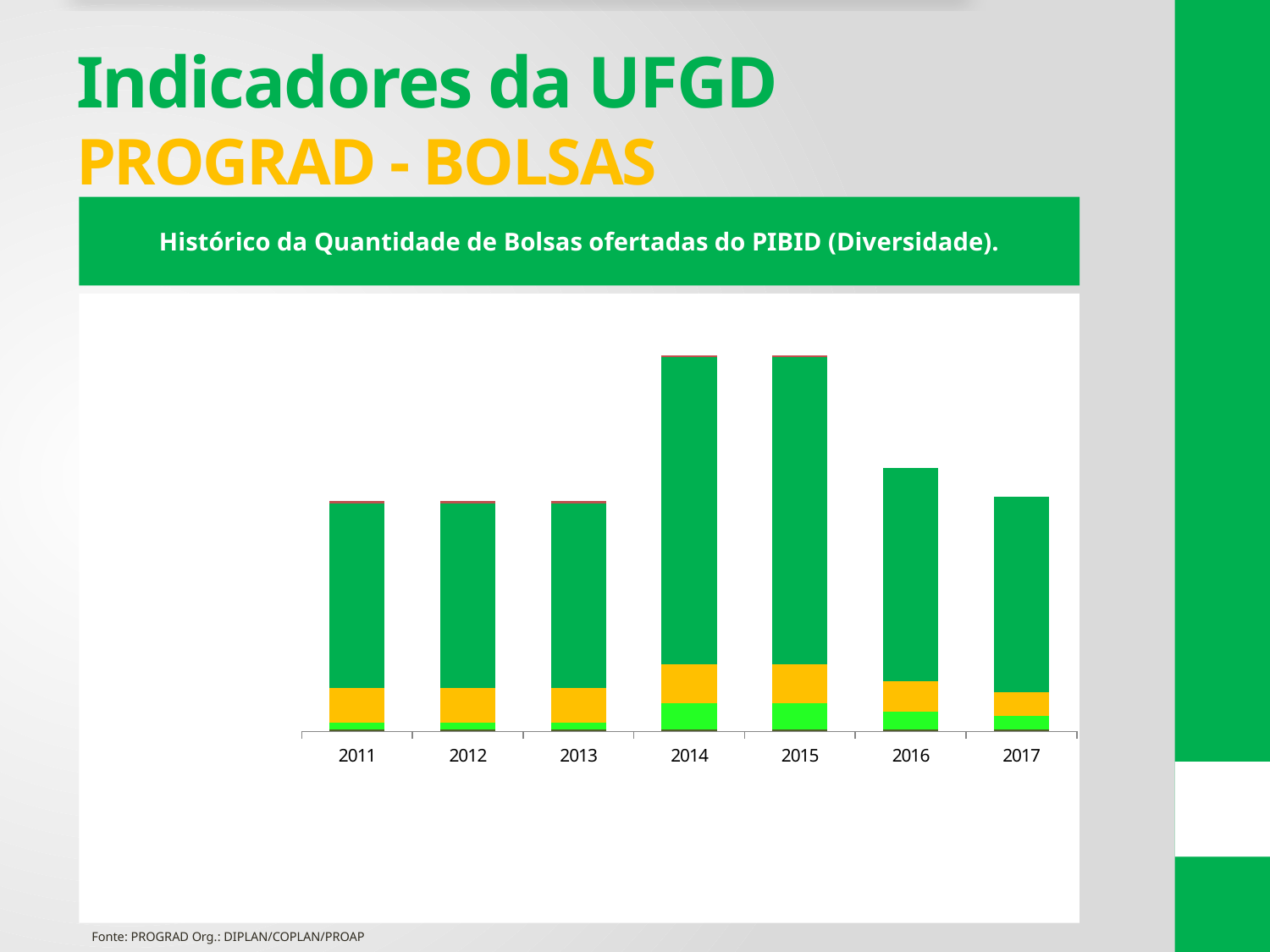
What is the last year shown on the x axis of the chart? 2017 Which bar is taller, 2016 or 2017? 2016 Do the total bar heights rise or fall from 2013 to 2014? Rise Which bar is taller, 2014 or 2016? 2014 Which bar is taller, 2011 or 2015? 2015 Do the total bar heights rise or fall from 2015 to 2017? Fall What is the first year shown on the x axis of the chart? 2011 What kind of chart is shown on the slide? Stacked bar chart How many years are shown on the x axis of the chart? 7 Which colour forms the largest segment of each stacked bar? Green